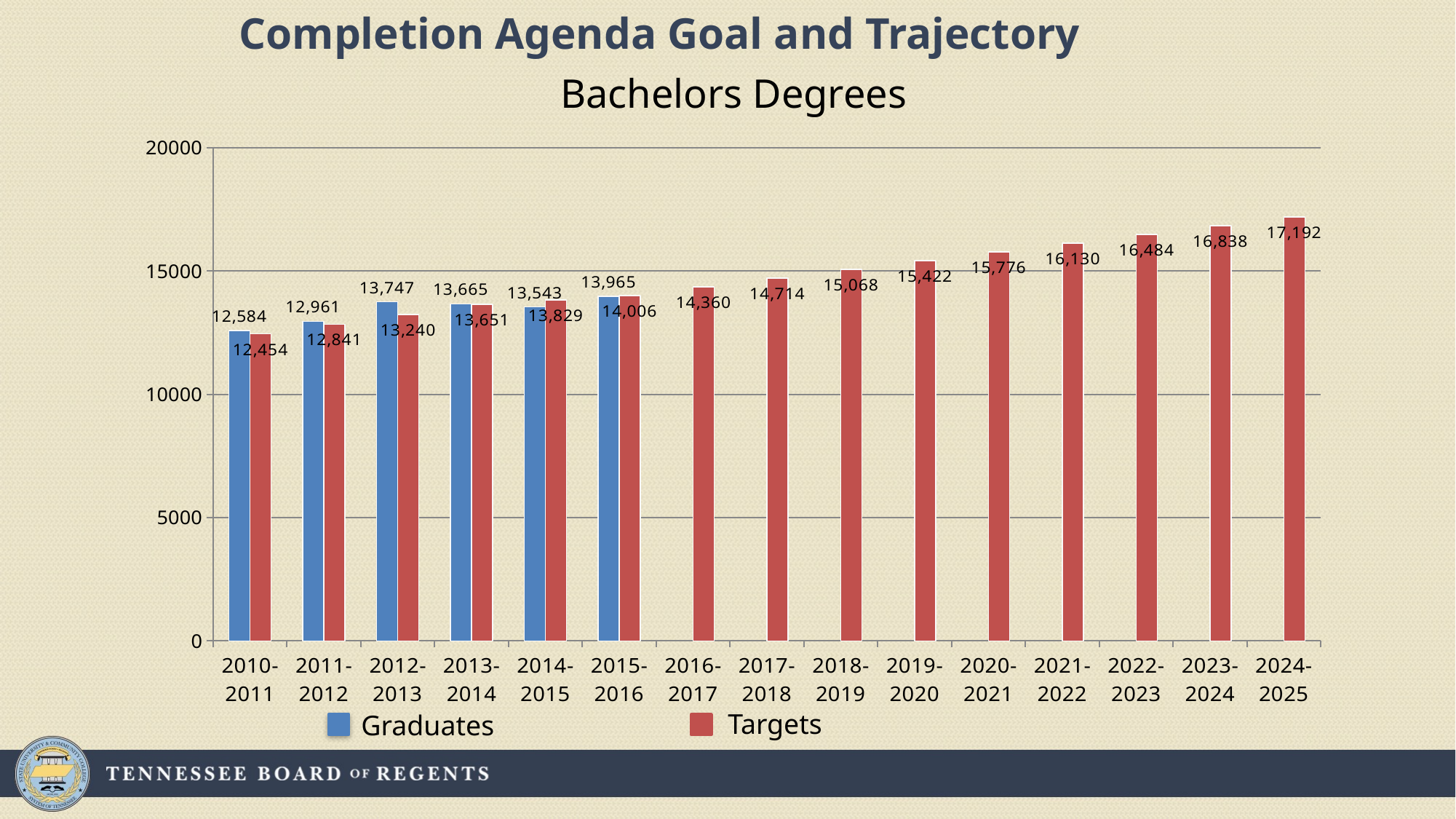
In 2014-2015, which is larger: Graduates or Targets? Targets By how much does the Graduates value exceed the Targets value in 2010-2011? 130 What is the Graduates value for 2012-2013? 13,747 In which year is the Targets value lowest? 2010-2011 What kind of chart is shown on the slide? bar chart How many academic years are shown on the x axis? 15 What is the Targets value for 2024-2025? 17,192 Is the Targets value for 2021-2022 greater or less than 15000? greater Do the Targets values rise or fall from 2010-2011 to 2024-2025? rise How many series does the legend list? 2 In which year is the Graduates value highest? 2015-2016 What is the Targets value for 2018-2019? 15,068